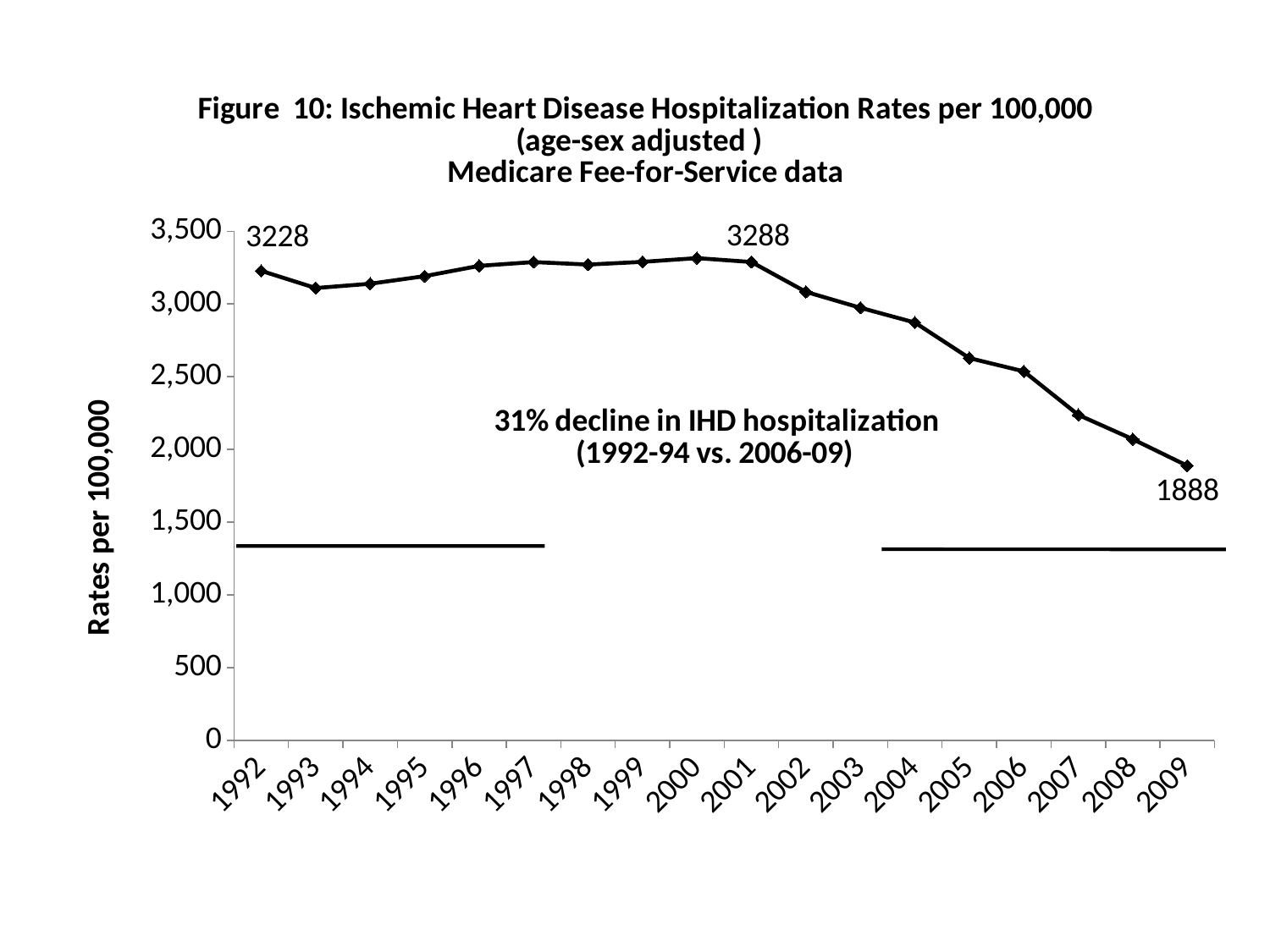
What is the hospitalization rate for 2009? 1888 What percentage decline in IHD hospitalization is stated in the chart annotation? 31% Do the values rise or fall from 2001 to 2009? fall What is the difference between the 1992 rate and the 2009 rate? 1340 Which year has the lowest hospitalization rate? 2009 What is the highest value printed as a data label on the chart? 3288 How many years are plotted on the x axis? 18 Which is larger, the rate for 1992 or the rate for 2009? 1992 Is the value for 2007 greater or less than 2,500? less What is the hospitalization rate for 1992? 3228 Is the value for 2005 greater or less than 2,500? greater What kind of chart is shown on the slide? line chart